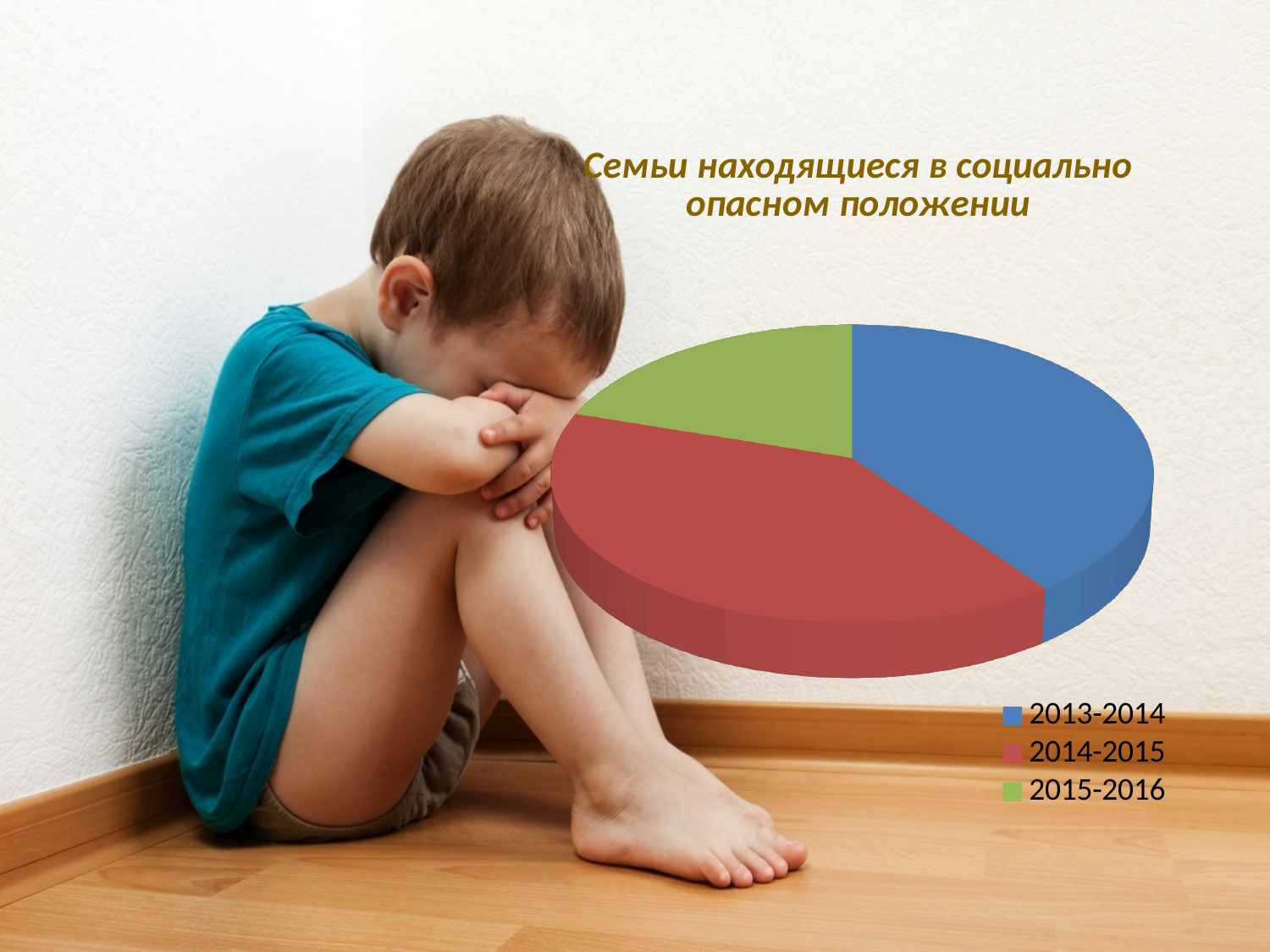
How many slices does the pie chart have? 3 How many entries does the legend list? 3 Which slice is larger, 2013-2014 or 2015-2016? 2013-2014 Which slice is larger, 2014-2015 or 2015-2016? 2014-2015 Which period is represented by the blue slice? 2013-2014 What is the title of the chart? Семьи находящиеся в социально опасном положении Which period is represented by the green slice? 2015-2016 Which period has the smallest slice of the pie? 2015-2016 What kind of chart is shown on the slide? pie chart What colour is the slice for 2014-2015? red